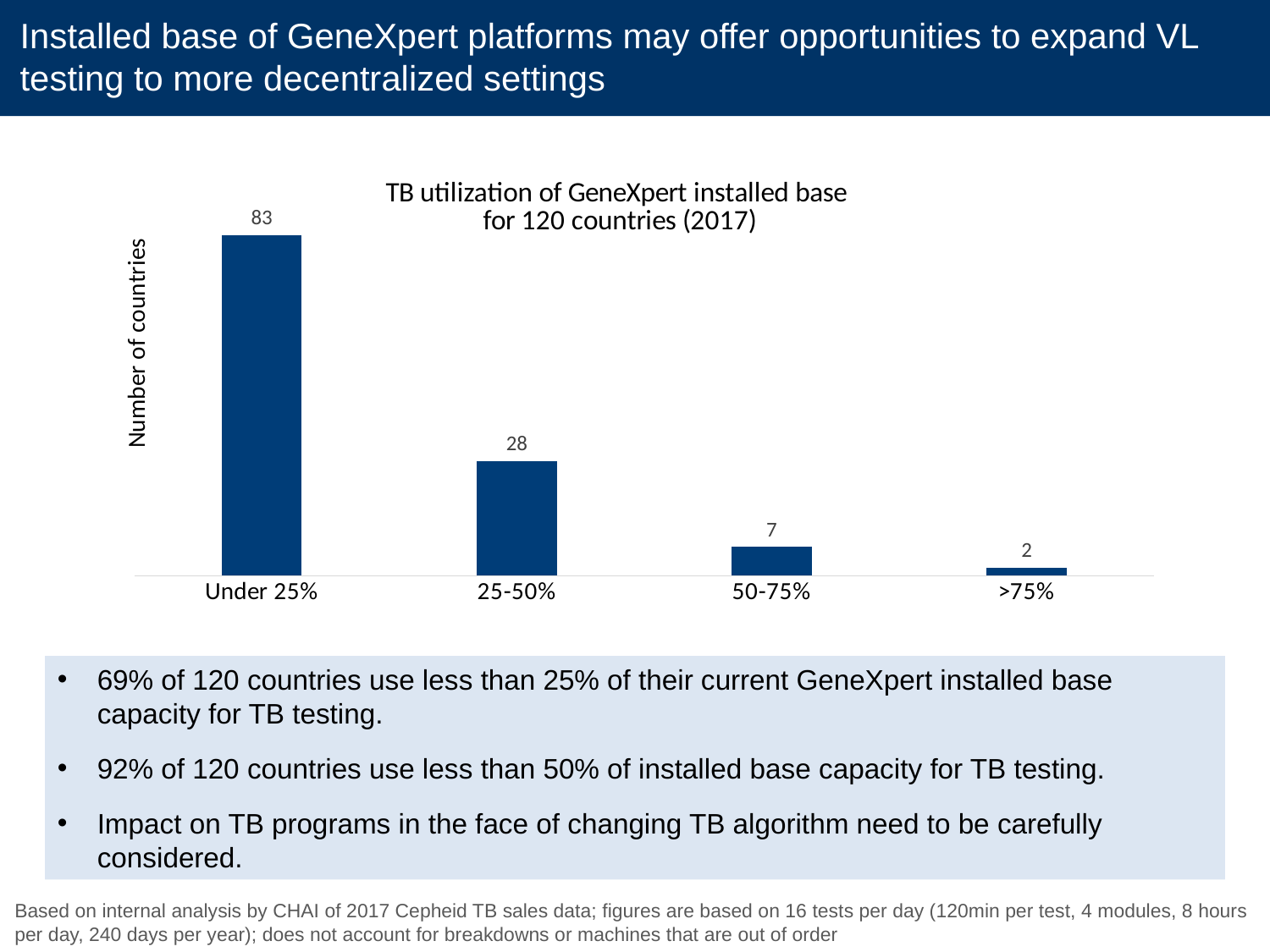
Which utilization category has the highest number of countries? Under 25% What is the difference in the number of countries between the Under 25% and 25-50% categories? 55 How many countries fall in the >75% utilization category? 2 What is the difference in the number of countries between the 50-75% and >75% categories? 5 Which utilization category has the lowest number of countries? >75% What type of chart is shown on the slide? Bar chart Which category has more countries, 25-50% or 50-75%? 25-50% How many utilization categories are shown on the x axis? 4 What is the number of countries in the 25-50% utilization category? 28 What is the number of countries in the 50-75% utilization category? 7 How many countries use under 25% of their GeneXpert installed base for TB testing? 83 What is the title of the chart? TB utilization of GeneXpert installed base for 120 countries (2017)